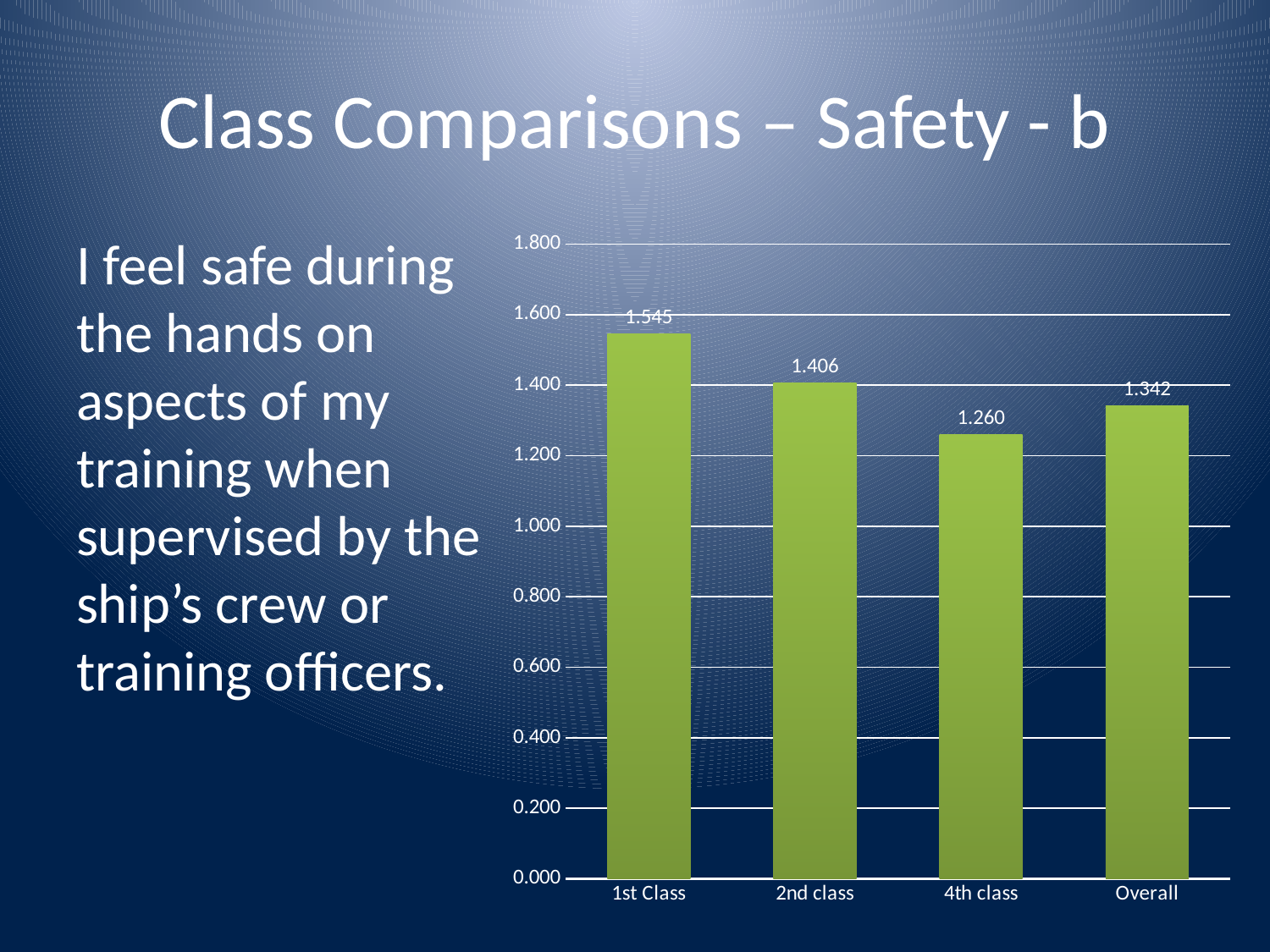
Which is larger, the value for 2nd class or the value for Overall? 2nd class What is the title of the slide containing the chart? Class Comparisons – Safety - b What is the value for Overall? 1.342 Which category has the highest value? 1st Class What is the value for 2nd class? 1.406 Is the value for 4th class greater or less than 1.400? less Which category has the lowest value? 4th class What is the value for 1st Class? 1.545 How many categories are shown on the x axis? 4 What is the value for 4th class? 1.260 What is the difference between the values for 1st Class and 4th class? 0.285 What kind of chart is shown on the slide? bar chart